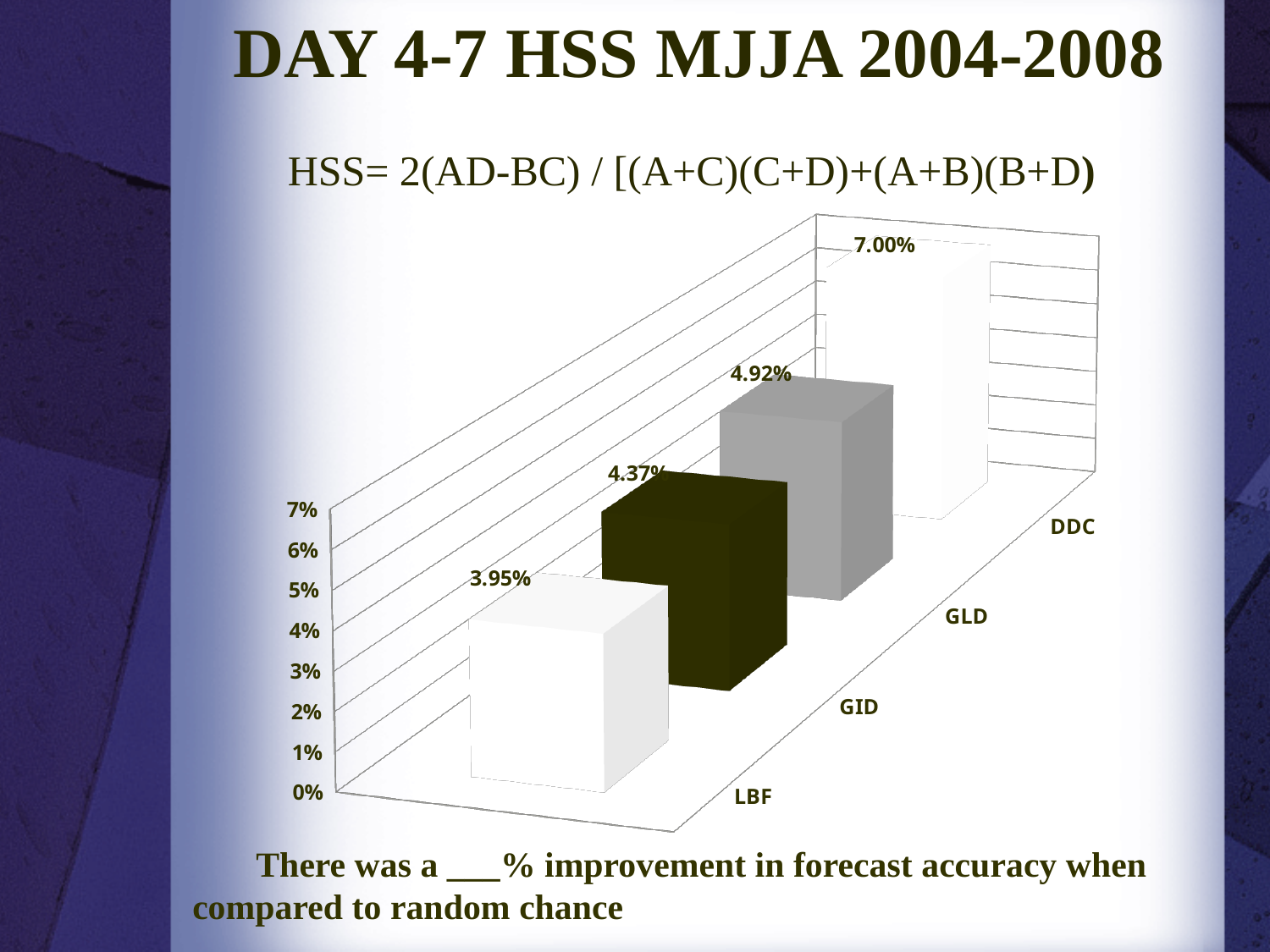
How many categories are shown in the chart? 4 What is the HSS value for GLD? 4.92% Which category has the lowest HSS value? LBF What is the HSS value for LBF? 3.95% What is the difference between the HSS values for DDC and LBF? 3.05% What is the HSS value for DDC? 7.00% Which category has the highest HSS value? DDC What is the HSS value for GID? 4.37% Is the value for GLD greater or less than 5%? less Do the values rise or fall going from LBF to DDC along the category axis? rise Which has a larger HSS value, GID or GLD? GLD What kind of chart is shown on the slide? bar chart